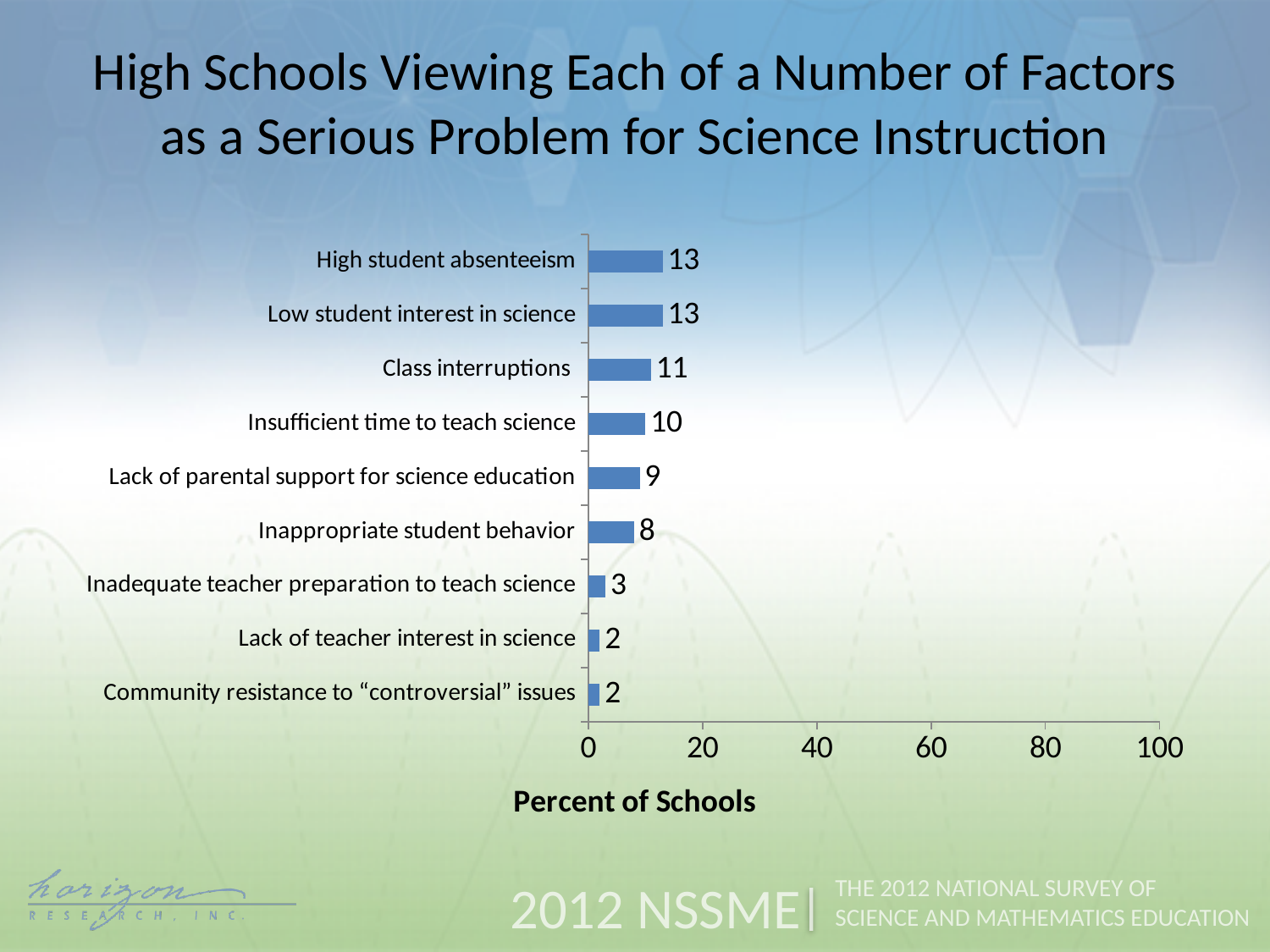
What is the value for 'Inadequate teacher preparation to teach science'? 3 Is the value for 'Low student interest in science' greater or less than 20? less What is the difference between the values for 'Insufficient time to teach science' and 'Inadequate teacher preparation to teach science'? 7 How many factors are listed in the chart? 9 Which factor has the highest value among 'Class interruptions', 'Insufficient time to teach science', and 'Inappropriate student behavior'? Class interruptions What is the value for 'Lack of parental support for science education'? 9 What kind of chart is shown on the slide? Bar chart Which factor has the lowest value, 'Inappropriate student behavior' or 'Lack of teacher interest in science'? Lack of teacher interest in science Which two factors share the highest value of 13? High student absenteeism and Low student interest in science What is the difference between the values for 'High student absenteeism' and 'Inappropriate student behavior'? 5 What percent of high schools view class interruptions as a serious problem for science instruction? 11 What is the label of the horizontal axis? Percent of Schools